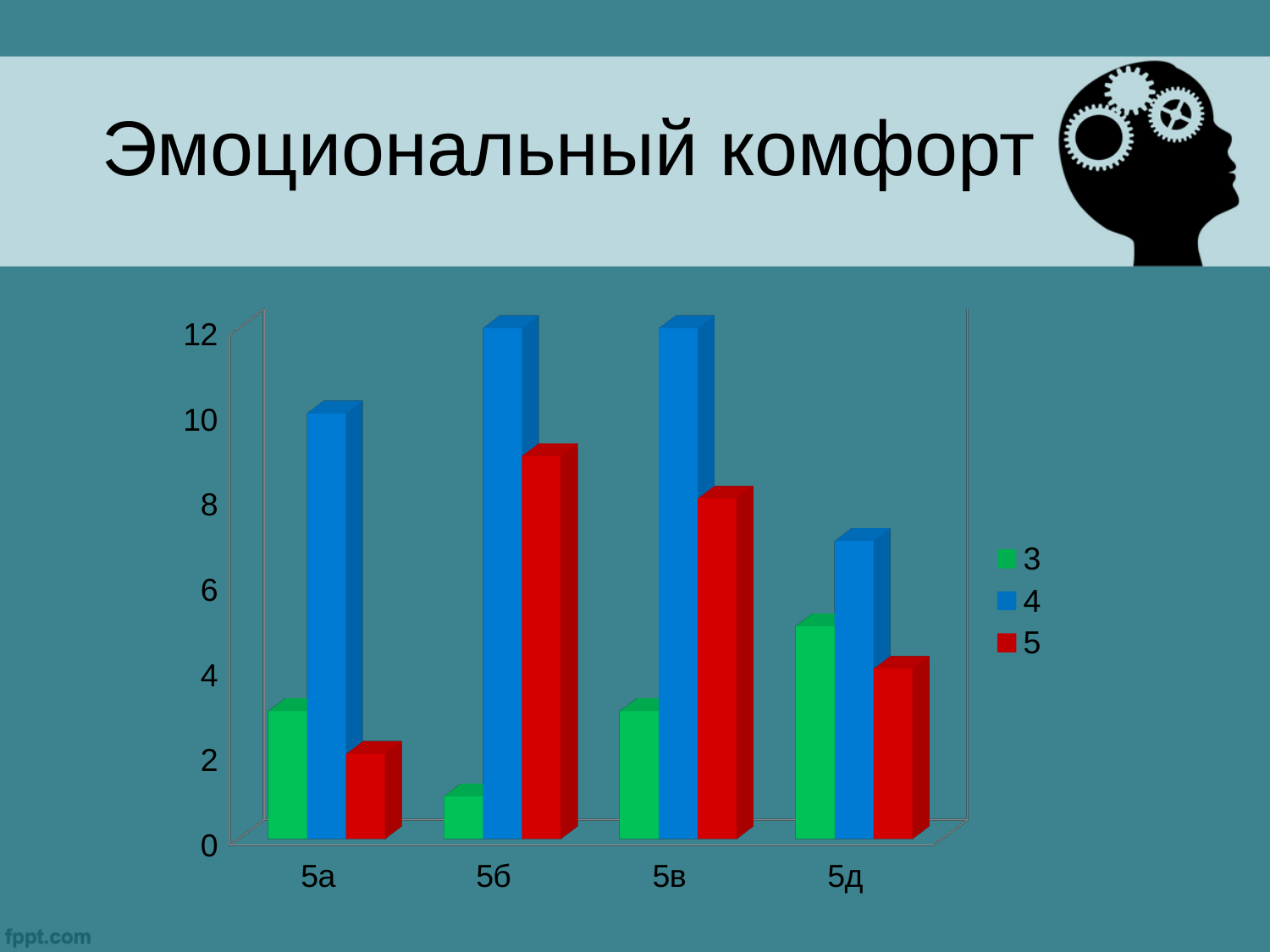
Which category has the lowest value for series 4? 5д Which category has the lowest value for series 5? 5а For category 5а, which series has the larger value, 4 or 5? 4 Which category has the lowest value for series 3? 5б What is the title of the slide containing the chart? Эмоциональный комфорт Which category has the highest value for series 3? 5д What kind of chart is shown on the slide? bar chart How many series does the chart legend list? 3 Is the value for series 3 in category 5б greater or less than 2? less Is the value for series 5 in category 5в greater or less than 6? greater How many categories are shown on the x axis of the chart? 4 Is the value for series 4 in category 5а greater or less than 8? greater